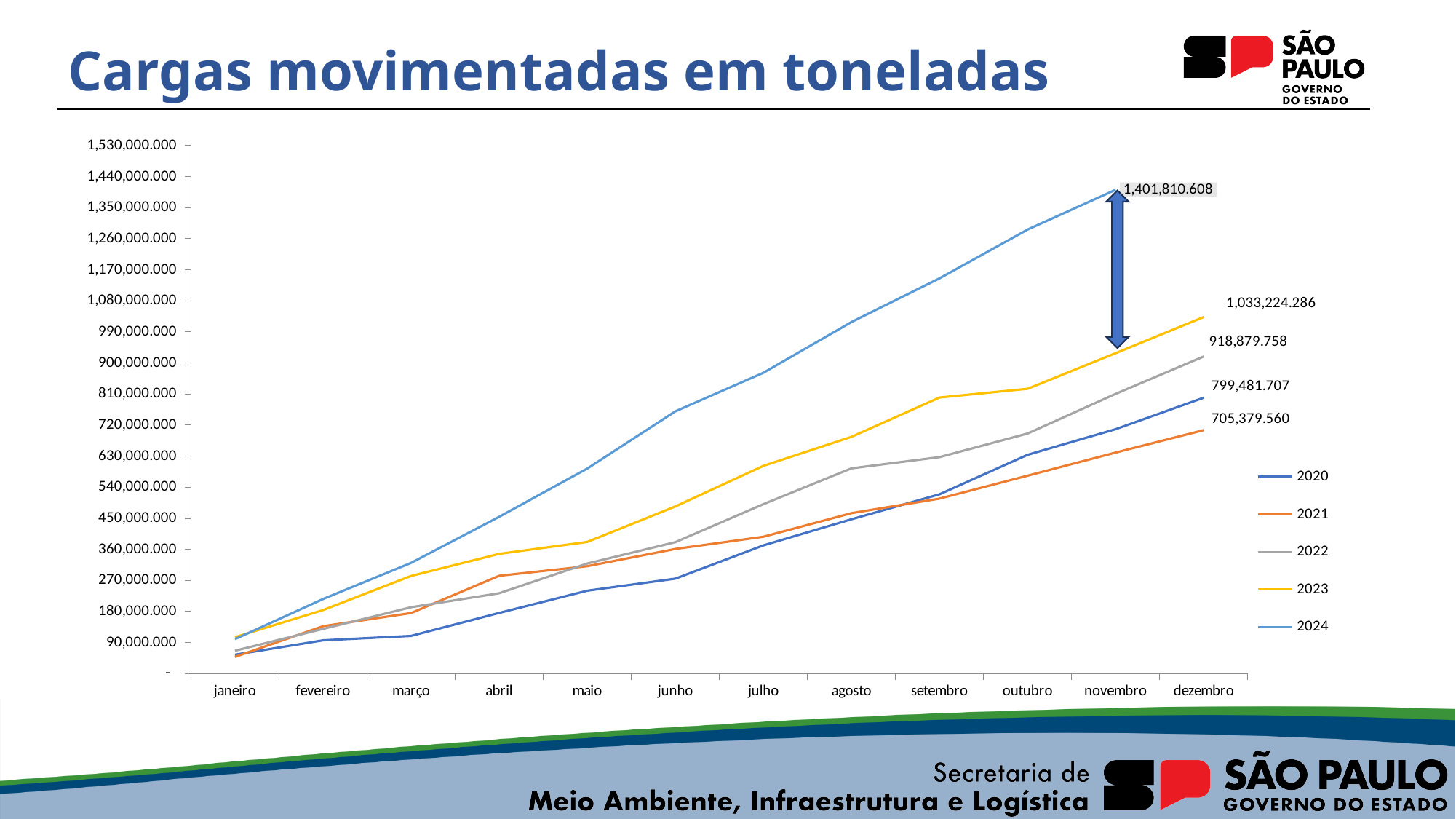
How many series does the legend list? 5 In dezembro, which series has the larger value, 2020 or 2021? 2020 What is the labelled value for the 2022 series in dezembro? 918,879.758 What is the difference between the 2023 and 2022 values in dezembro? 114,344.528 What is the labelled value for the 2020 series in dezembro? 799,481.707 What is the labelled value for the 2021 series in dezembro? 705,379.560 What is the labelled value for the 2024 series in novembro? 1,401,810.608 How many months are shown along the x axis? 12 What kind of chart is shown on the slide? line chart Is the value for the 2020 series in junho greater or less than 360,000,000? less What is the labelled value for the 2023 series in dezembro? 1,033,224.286 Which series has the highest value in novembro? 2024